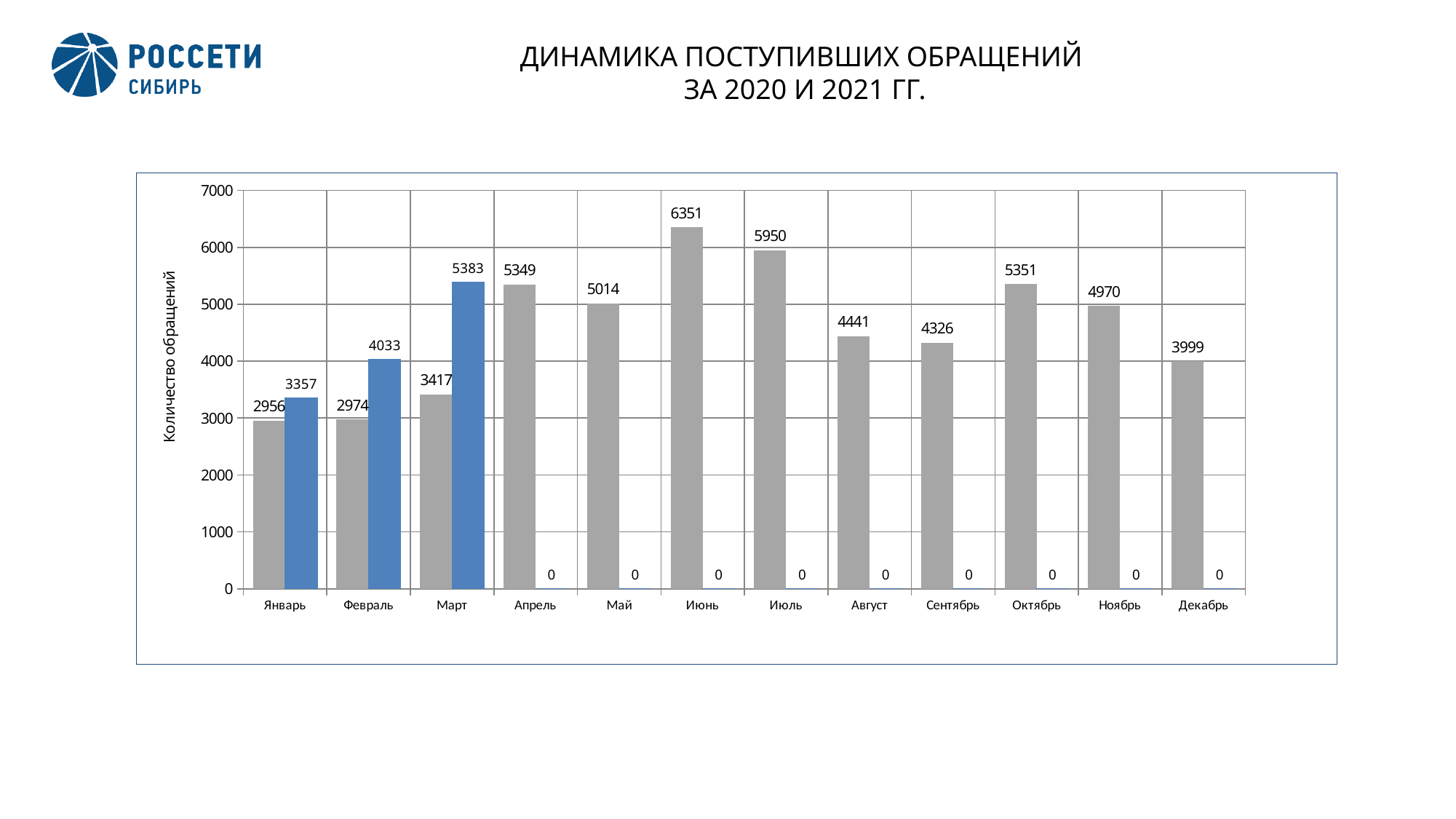
For Март, which is larger, the grey bar or the blue bar? the blue bar How many months are shown on the x axis? 12 What is the value of the blue bar for Март? 5383 What is the value of the grey bar for Декабрь? 3999 Is the grey bar for Октябрь greater or less than 5000? greater What is the label of the vertical axis? Количество обращений What is the difference between the grey bars for Июнь and Июль? 401 Which month has the lowest grey bar? Январь Which month has the highest grey bar? Июнь What is the value of the grey bar for Июнь? 6351 What kind of chart is shown on the slide? bar chart What is the difference between the blue bar and the grey bar for Февраль? 1059